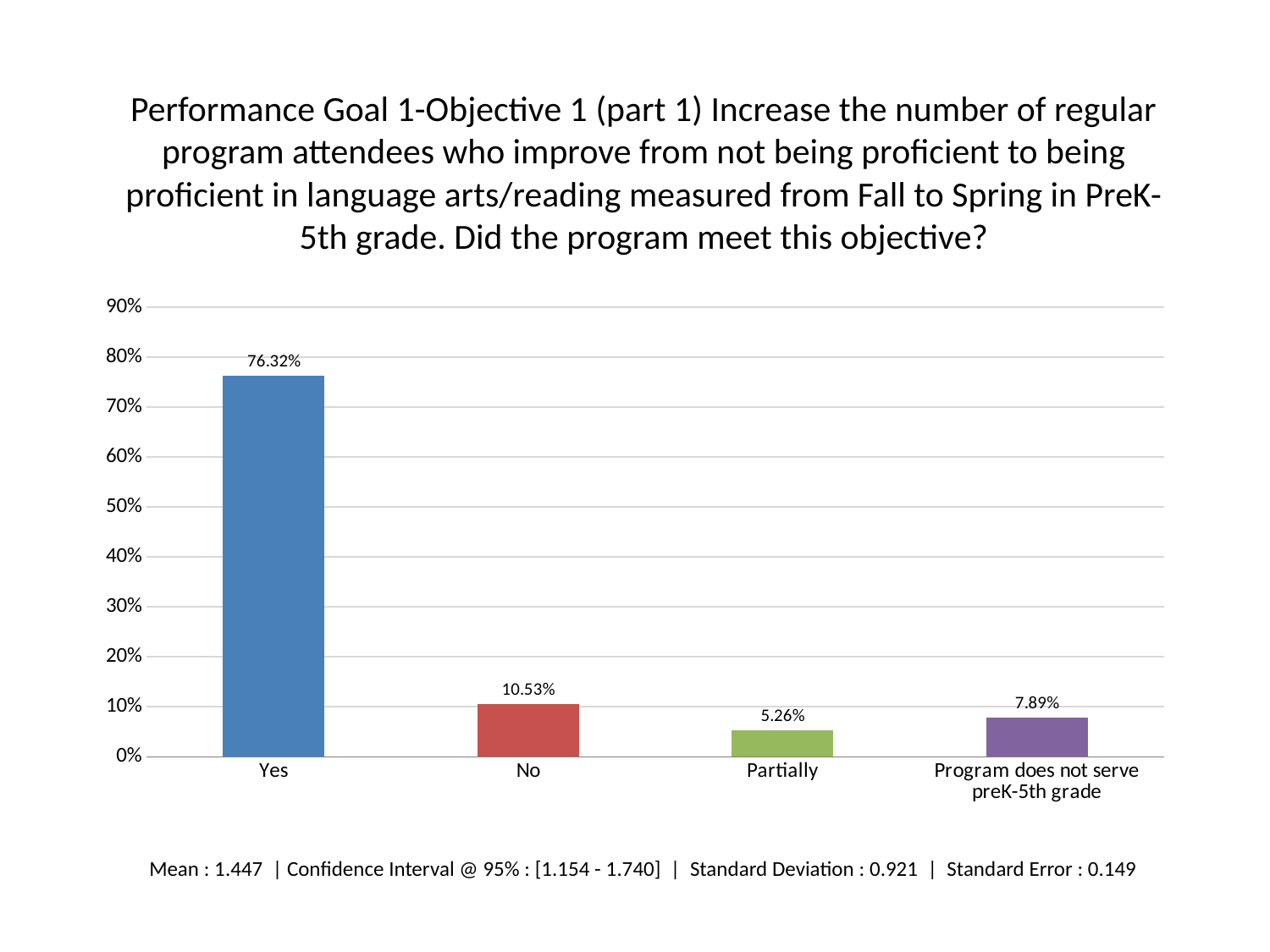
What mean value is reported in the text below the chart? 1.447 What is the difference in percentage points between "Yes" and "No"? 65.79 Which response category has the highest percentage? Yes What percentage of respondents answered "No"? 10.53% How many response categories are shown on the x axis? 4 Is the value for "Yes" greater or less than 70%? greater What kind of chart is shown on the slide? Bar chart Which is larger, the value for "No" or the value for "Program does not serve preK-5th grade"? No What percentage of respondents answered "Partially"? 5.26% Which response category has the lowest percentage? Partially What percentage of respondents answered "Program does not serve preK-5th grade"? 7.89% What percentage of respondents answered "Yes"? 76.32%